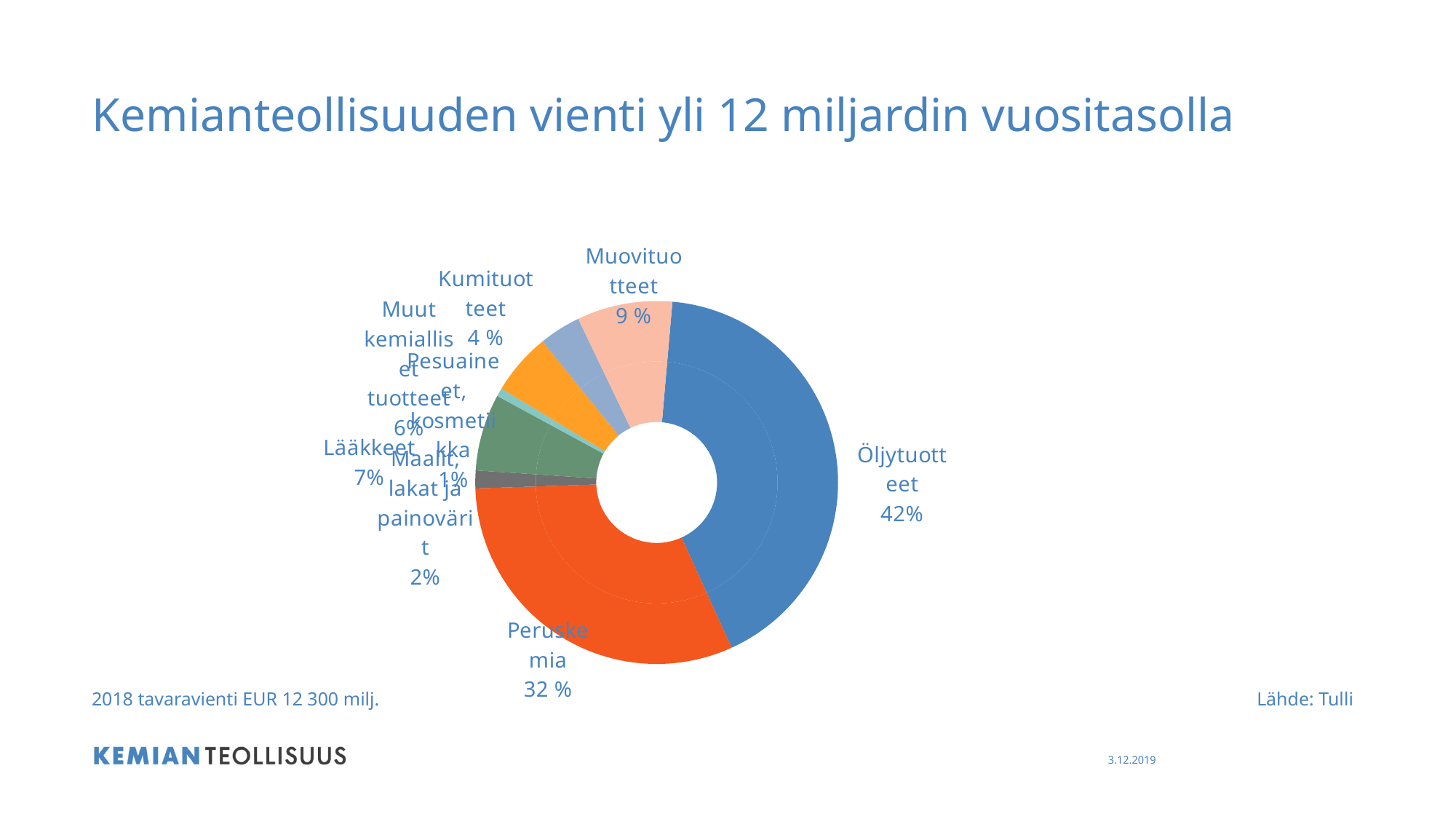
What is the value shown for Lääkkeet? 7% What kind of chart is shown on the slide? Doughnut (pie) chart How many categories are shown in the chart? 8 What is the value shown for Peruskemia? 32 % Which is larger, the share for Lääkkeet or the share for Muut kemialliset tuotteet? Lääkkeet What share of exports do Öljytuotteet account for? 42% What percentage is shown for Muovituotteet? 9 % What is the difference in percentage points between Öljytuotteet and Peruskemia? 10 percentage points What percentage is shown for Kumituotteet? 4 % Which category has the largest share of the chart? Öljytuotteet What is the title of the slide? Kemianteollisuuden vienti yli 12 miljardin vuositasolla Which category has the smallest share of the chart? Pesuaineet, kosmetiikka